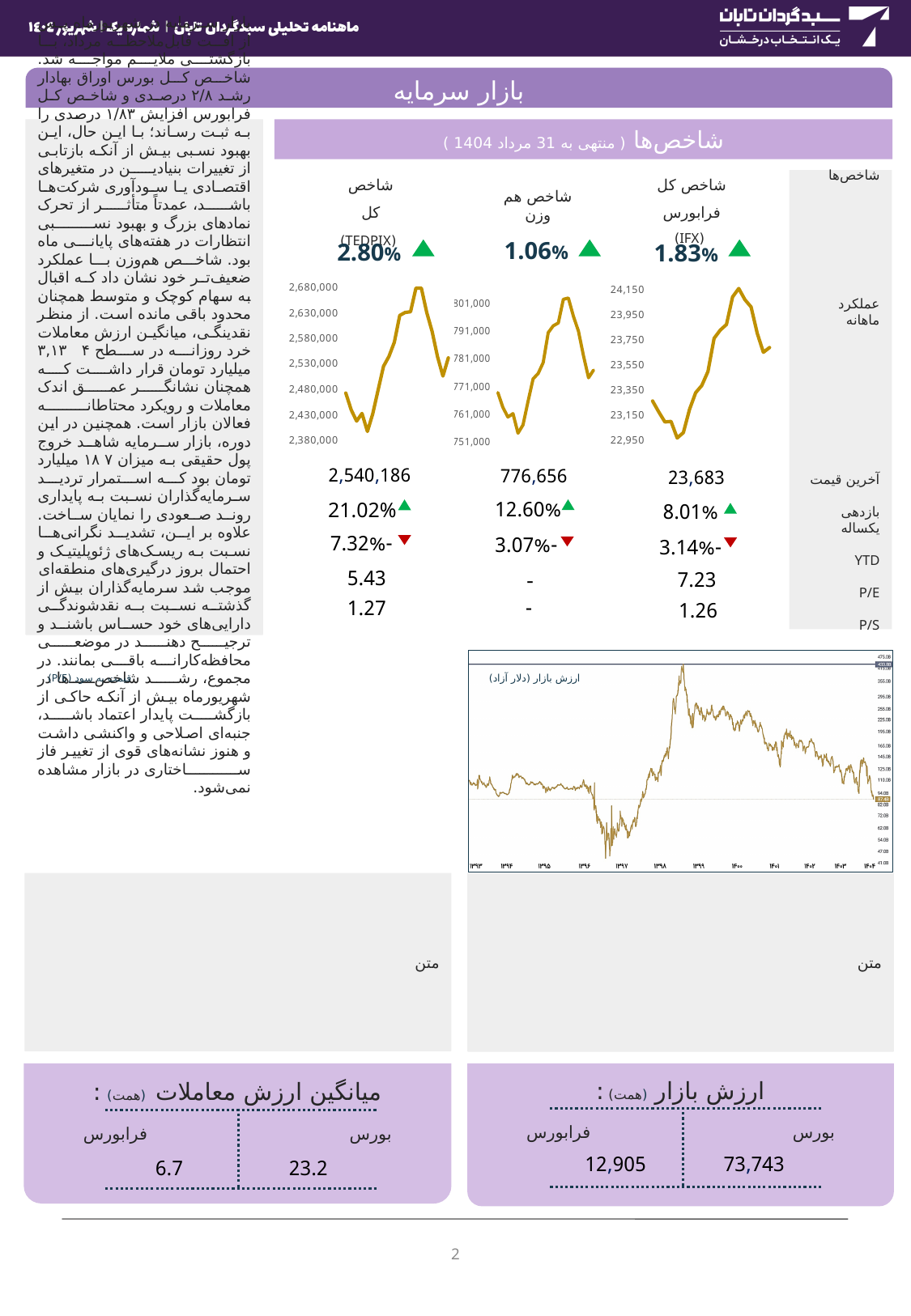
In the large market value chart (ارزش بازار (دلار آزاد)), do the values rise or fall from 1399 to 1404? fall In the TEDPIX (شاخص کل) chart, is the peak value greater or less than 2,630,000? greater Among the three index charts, which index shows the lowest monthly change? شاخص هم وزن What monthly change is printed above the TEDPIX (شاخص کل) chart? 2.80% What monthly change is printed above the IFX (شاخص کل فرابورس) chart? 1.83% What is the title of the large chart in the lower right of the slide? ارزش بازار (دلار آزاد) What is the difference between the monthly change of TEDPIX (2.80%) and IFX (1.83%)? 0.97% In the equal-weight index (شاخص هم وزن) chart, is the peak value greater or less than 791,000? greater Among the three index charts, which index shows the highest monthly change? شاخص کل (TEDPIX) In the IFX (شاخص کل فرابورس) chart, is the lowest point greater or less than 23,150? less What monthly change is printed above the equal-weight index (شاخص هم وزن) chart? 1.06% What kind of chart is used for the monthly performance of the TEDPIX index (شاخص کل)? line chart